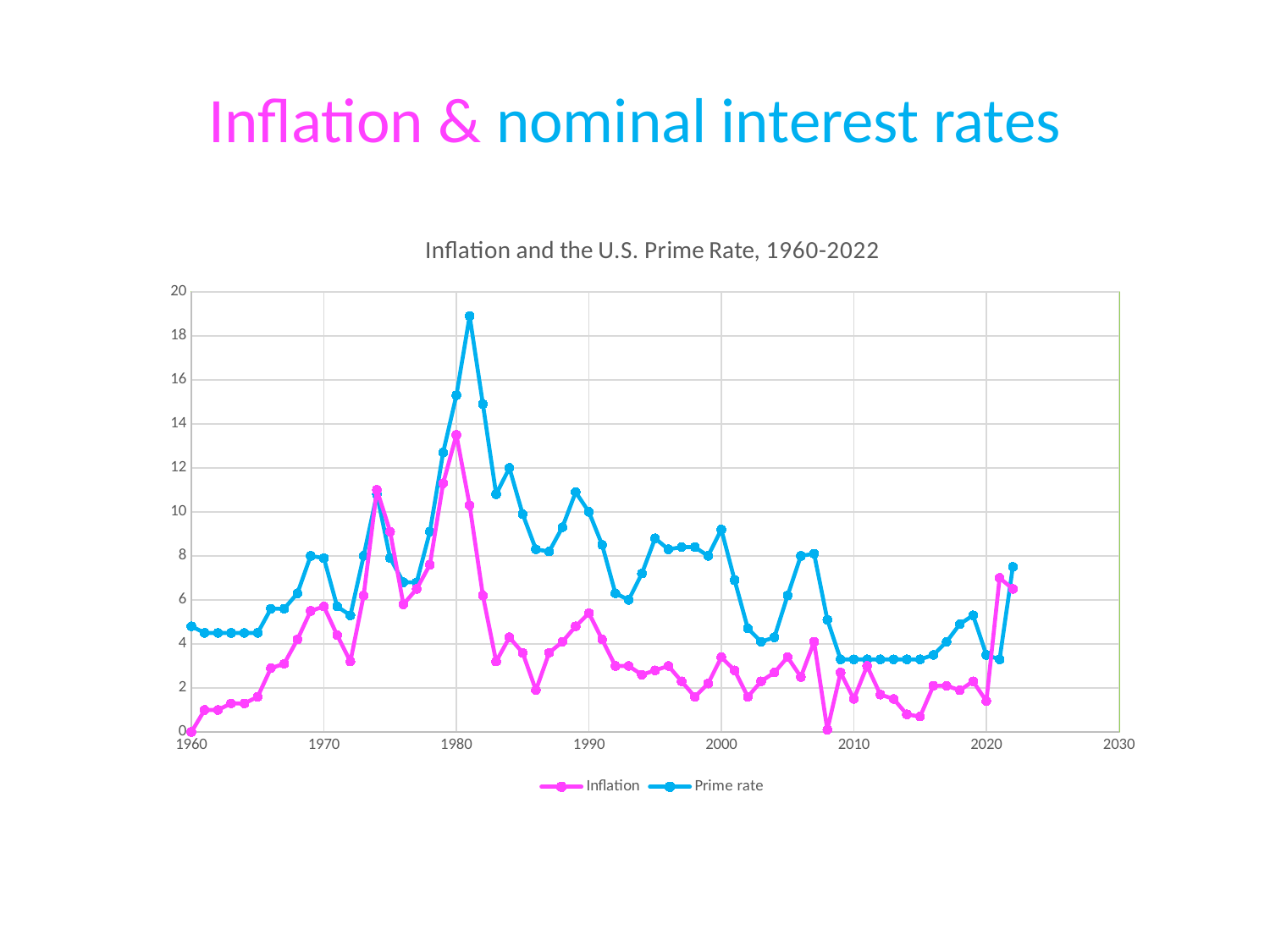
In 1980, which is larger, the Prime rate or Inflation? Prime rate Is the Prime rate value for 2010 greater or less than 4? less What is the title of the chart? Inflation and the U.S. Prime Rate, 1960-2022 Is the Inflation value for 2020 greater or less than 2? less Which series reaches the highest value anywhere on the chart? Prime rate What kind of chart is shown on the slide? Line chart Is the Inflation value for 1980 greater or less than 12? greater Which colour is used for the Prime rate series? Blue Does the Prime rate generally rise or fall between 1980 and 1990? Fall How many series does the legend list? 2